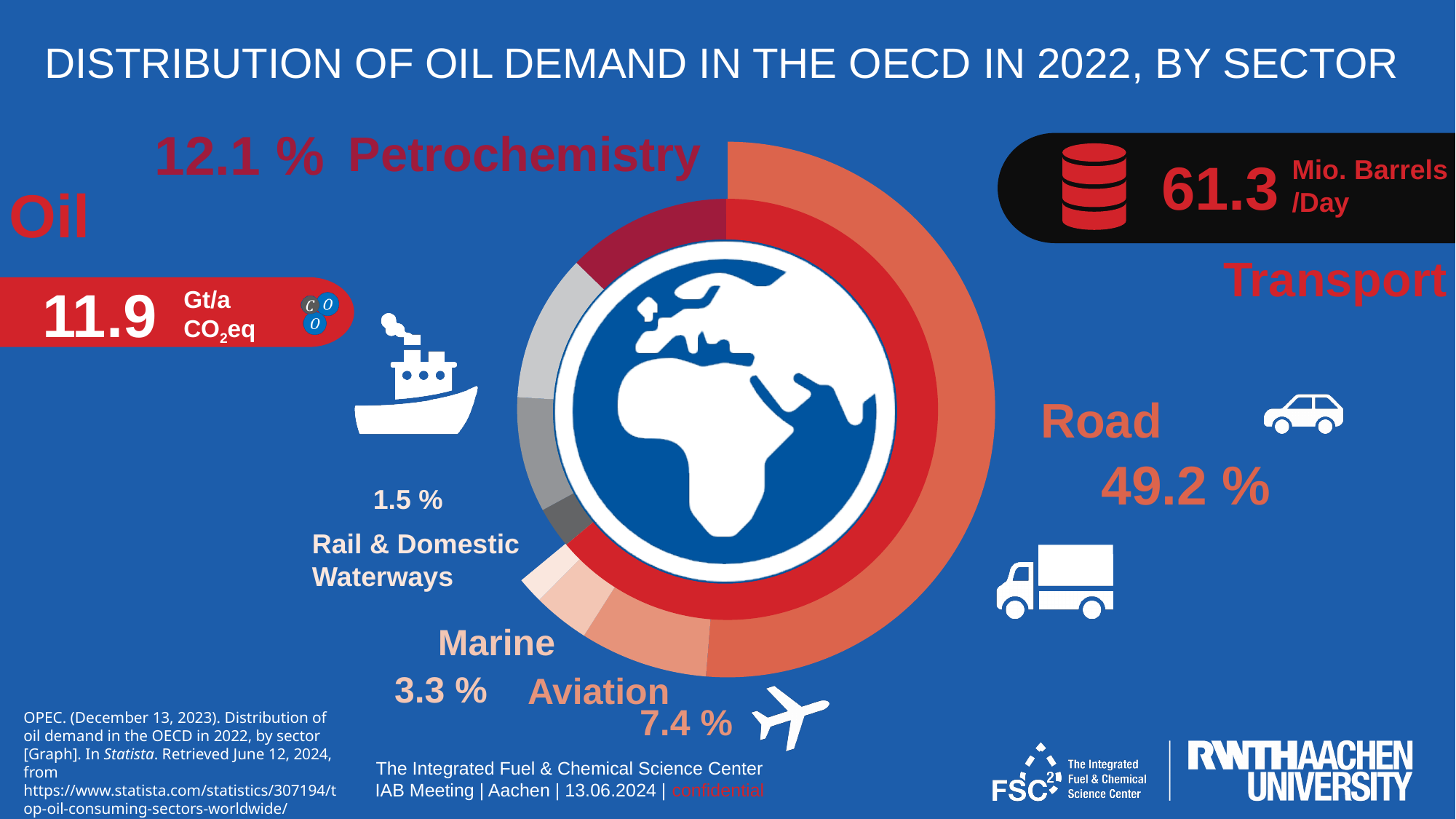
Which labelled sector has the largest share of oil demand? Road Which labelled sector has the smallest share of oil demand? Rail & Domestic Waterways What is the percentage shown for Marine? 3.3 % Which has a larger share of oil demand, Aviation or Marine? Aviation What share of oil demand does Petrochemistry account for? 12.1 % What is the combined share of the four transport sub-sectors (Road, Aviation, Marine, Rail & Domestic Waterways)? 61.4 % What share of oil demand is attributed to Rail & Domestic Waterways? 1.5 % What is the total OECD oil demand shown in million barrels per day? 61.3 Mio. Barrels/Day By how many percentage points does the Road share exceed the Petrochemistry share? 37.1 What percentage of OECD oil demand in 2022 is attributed to the Road sector? 49.2 % What is the percentage shown for Aviation? 7.4 % What kind of chart is used to show the distribution of oil demand? Pie (donut) chart